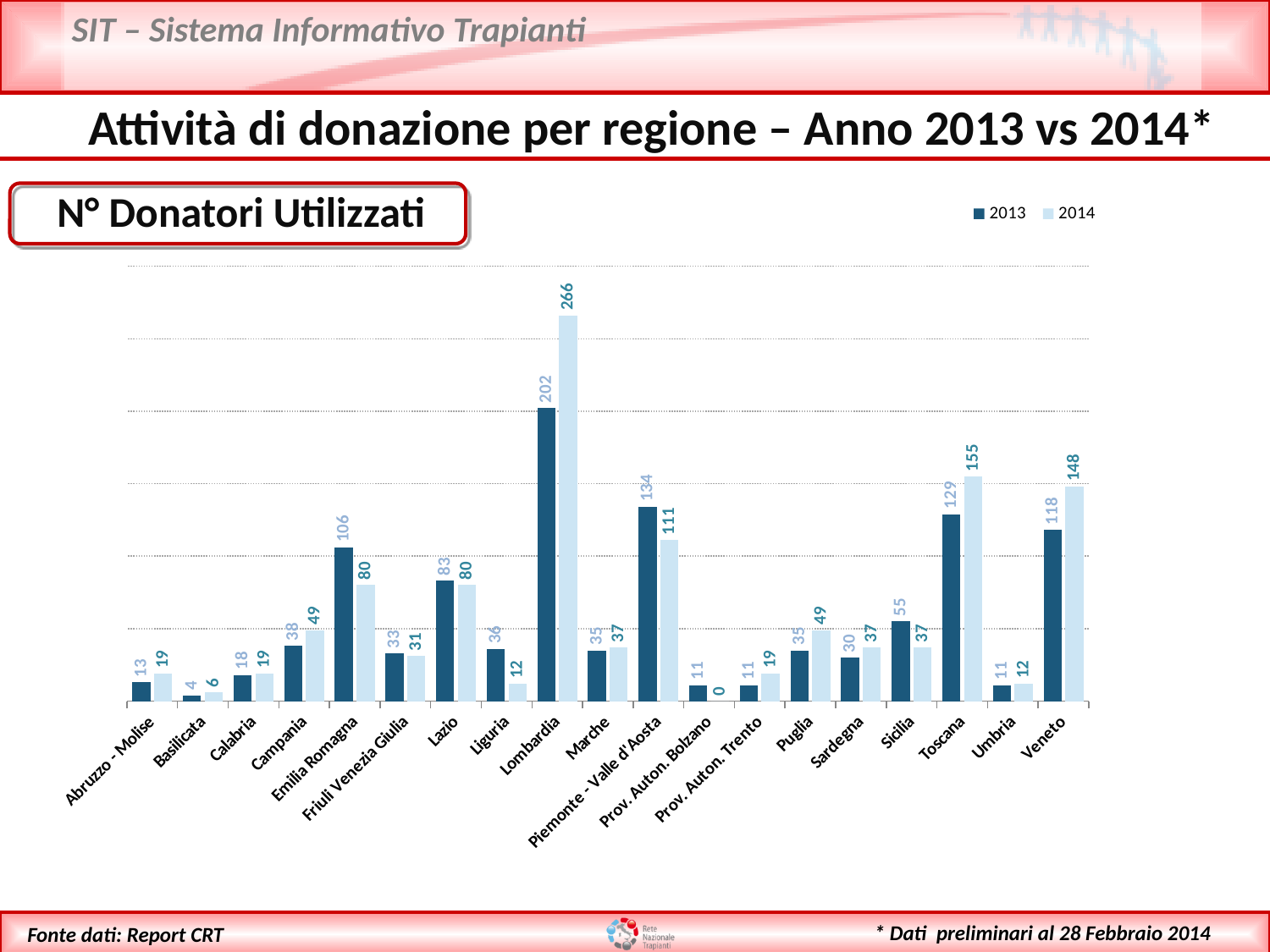
Which region has the highest value in the 2013 series? Lombardia How many regions are shown on the x axis? 19 What is the title shown in the box above the chart? N° Donatori Utilizzati What is the value for Lombardia in the 2014 series? 266 What is the difference between the 2014 and 2013 values for Toscana? 26 How many series does the legend list? 2 What is the difference between the 2013 and 2014 values for Liguria? 24 What kind of chart is shown on the slide? Bar chart Which region has the lowest value in the 2013 series? Basilicata What is the value for Piemonte - Valle d'Aosta in the 2013 series? 134 Which is larger for Emilia Romagna, the 2013 value or the 2014 value? 2013 What is the value for Prov. Auton. Bolzano in the 2014 series? 0